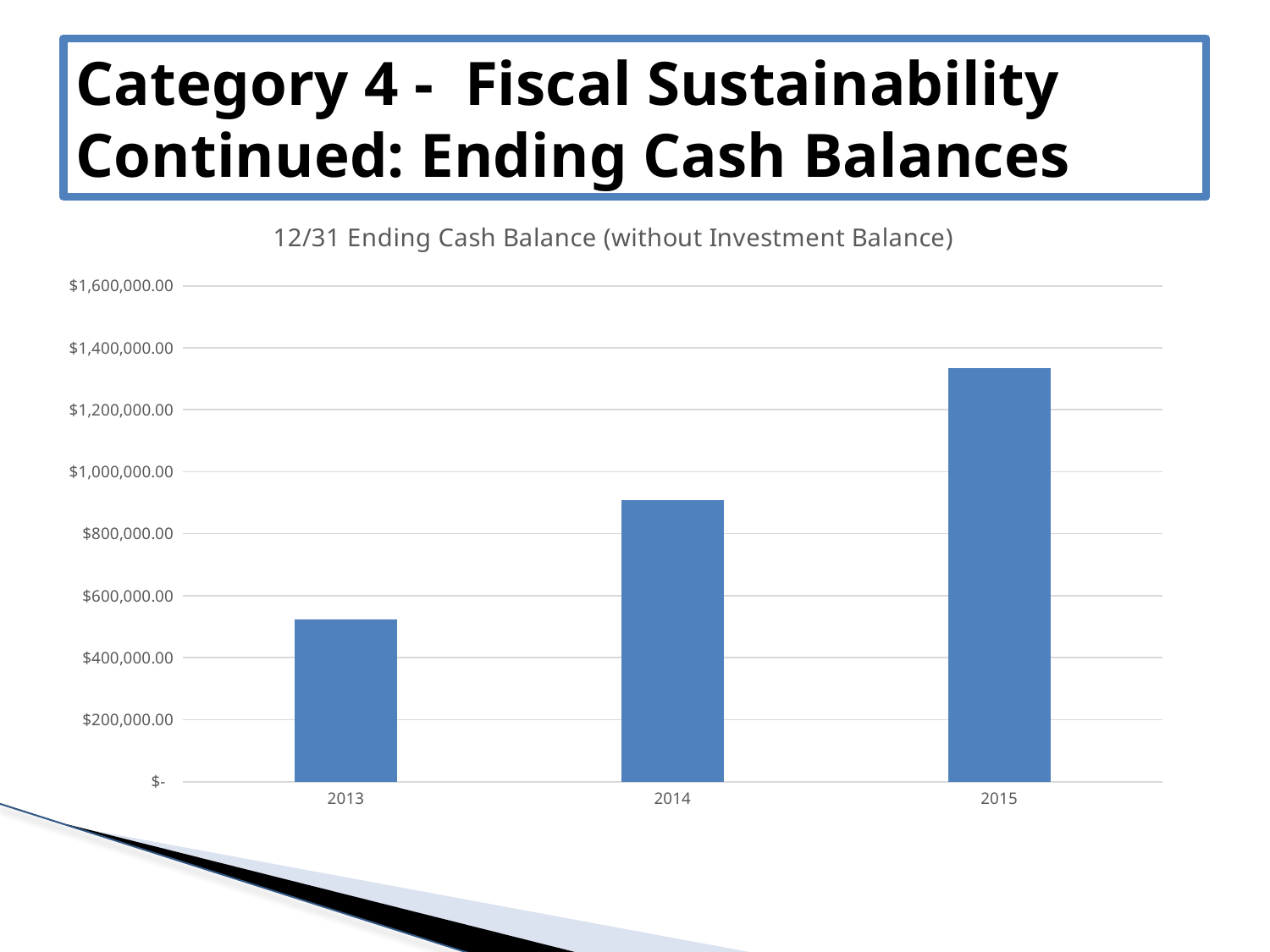
What kind of chart is shown on the slide? bar chart Is the ending cash balance for 2013 greater or less than $600,000.00? less What is the title of the chart? 12/31 Ending Cash Balance (without Investment Balance) How many years are shown on the x axis of the chart? 3 Do the ending cash balances rise or fall from 2013 to 2015? rise What is the highest value labelled on the vertical axis of the chart? $1,600,000.00 Which year has a larger ending cash balance, 2013 or 2014? 2014 Is the ending cash balance for 2015 greater or less than $1,200,000.00? greater Which year has the lowest ending cash balance? 2013 Is the ending cash balance for 2015 greater or less than $1,400,000.00? less Which year has the highest ending cash balance? 2015